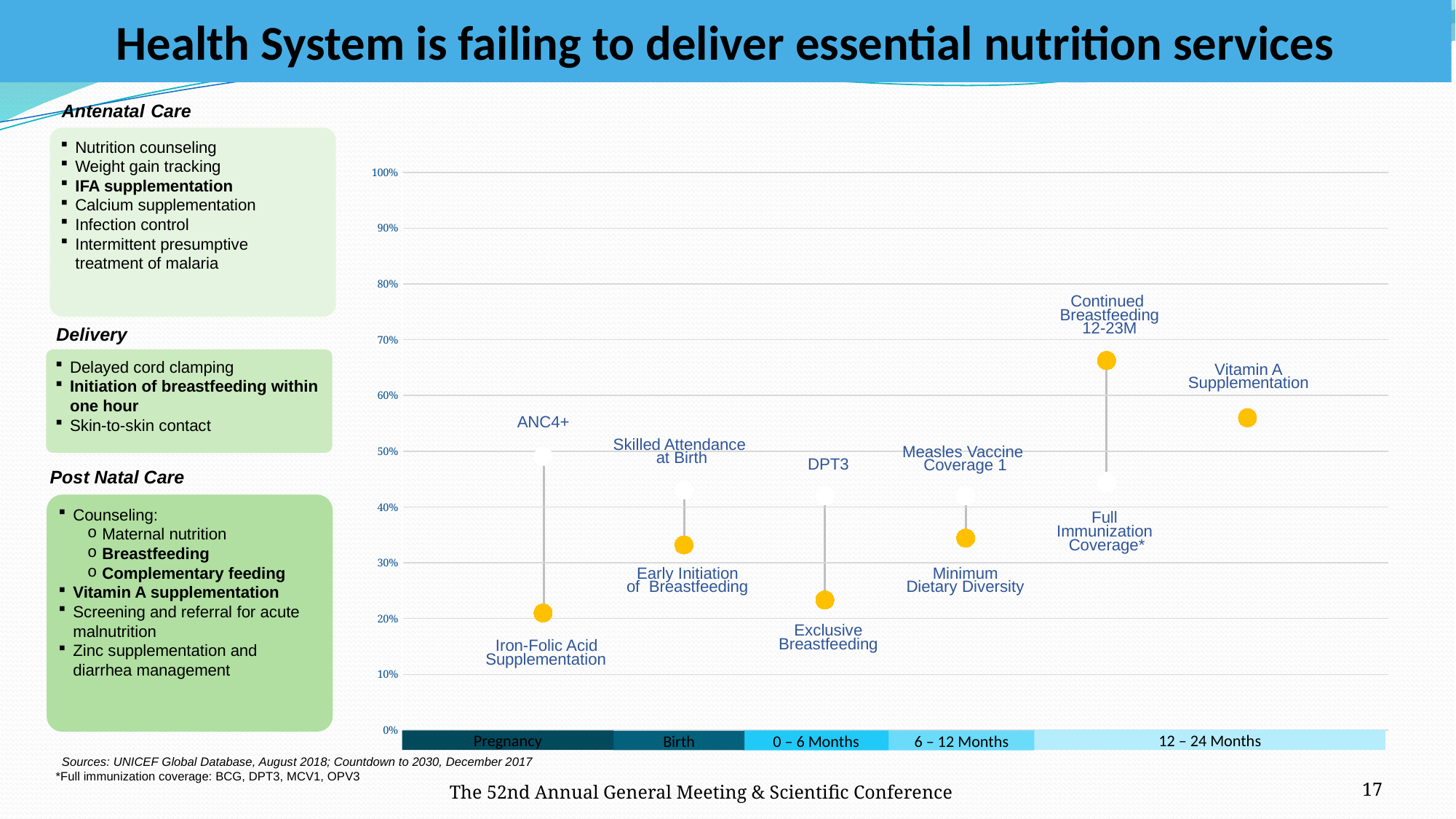
Is the value for Minimum Dietary Diversity greater or less than 40%? less Is the value for Vitamin A Supplementation greater or less than 50%? greater Is the value for Iron-Folic Acid Supplementation greater or less than 30%? less Which is larger, Continued Breastfeeding 12-23M or Vitamin A Supplementation? Continued Breastfeeding 12-23M How many time-period segments are shown along the x axis of the chart? 5 What is the highest value shown on the chart's y axis? 100% What is the label of the first time-period segment on the x axis? Pregnancy Which is larger, Skilled Attendance at Birth or Early Initiation of Breastfeeding? Skilled Attendance at Birth Which indicator has the highest value on the chart? Continued Breastfeeding 12-23M